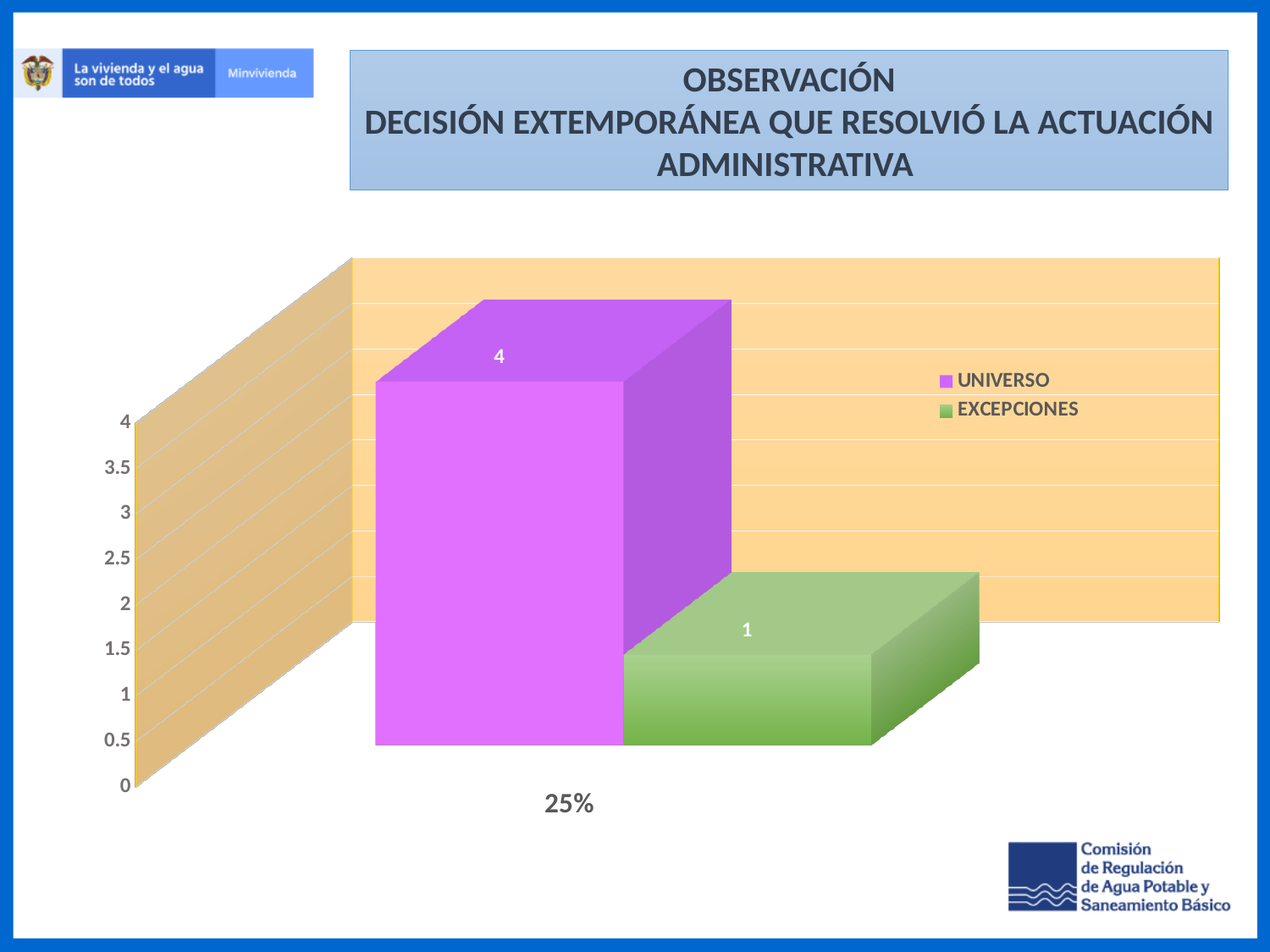
Is the value for UNIVERSO greater or less than 3? greater What kind of chart is shown on the slide? bar chart What is the value of the EXCEPCIONES bar? 1 What is the category label shown on the x axis? 25% Which series has the lowest value? EXCEPCIONES How many series does the legend list? 2 What is the value of the UNIVERSO bar? 4 What is the difference between the UNIVERSO and EXCEPCIONES values? 3 Is the value for EXCEPCIONES greater or less than 2? less What is the highest value shown on the vertical axis? 4 What colour is the EXCEPCIONES bar? green Which series has the higher value, UNIVERSO or EXCEPCIONES? UNIVERSO